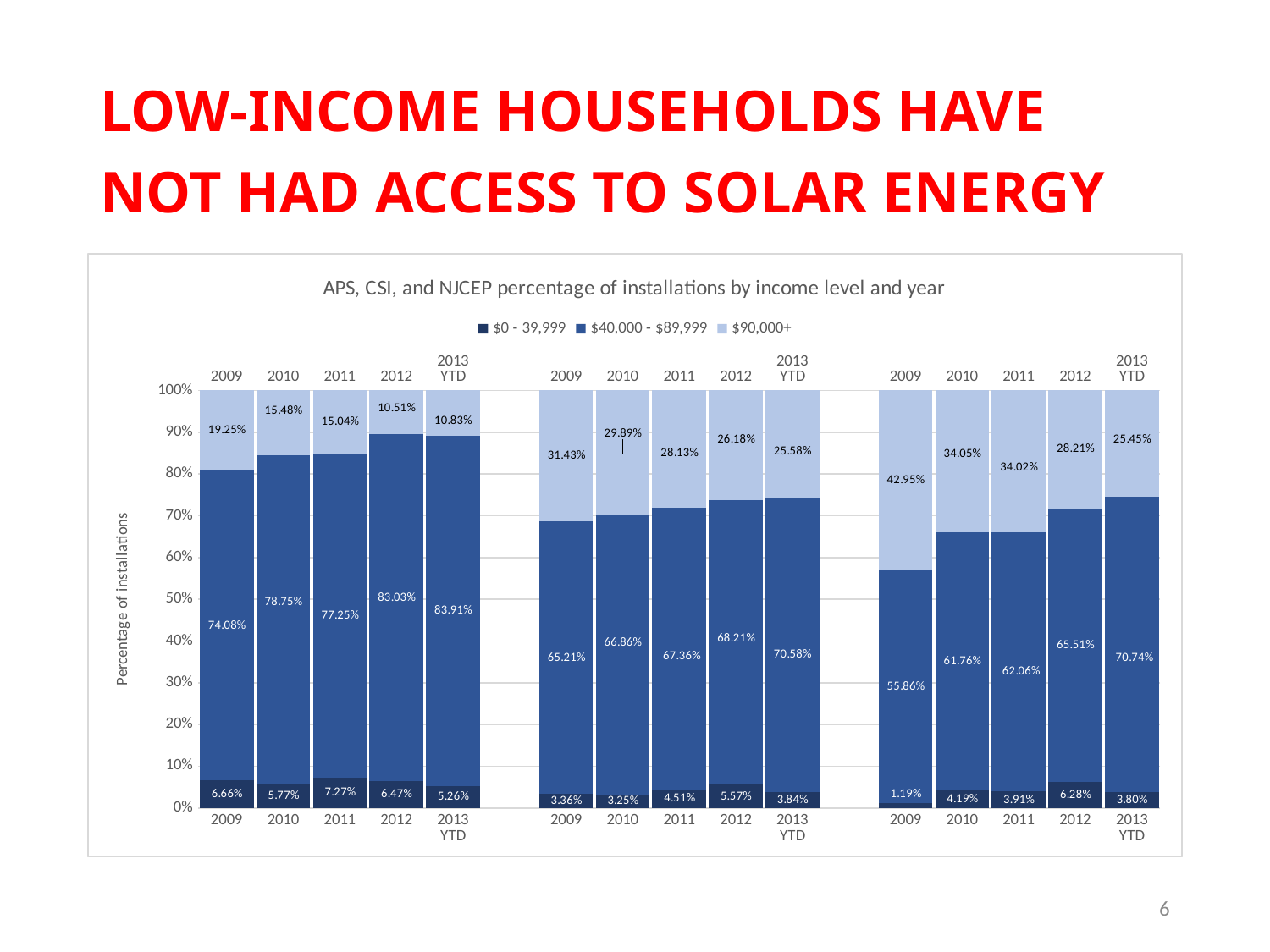
In the right group of bars, what is the value for the $40,000 - $89,999 series in 2013 YTD? 70.74% In the right group of bars, which year has the lowest value for the $0 - 39,999 series? 2009 In the left group of bars, what is the value for the $0 - 39,999 series in 2011? 7.27% In the middle group of bars, what is the value for the $90,000+ series in 2009? 31.43% How many years are shown in each group of bars? 5 What kind of chart is shown on the slide? Stacked bar chart How many series does the legend list? 3 In the middle group of bars, what is the difference between the $90,000+ values for 2009 and 2013 YTD? 5.85% What is the title of the chart? APS, CSI, and NJCEP percentage of installations by income level and year In the right group of bars, does the $90,000+ value rise or fall from 2009 to 2013 YTD? Fall In the left group of bars, which year has the highest value for the $40,000 - $89,999 series? 2013 YTD In the left group of bars, is the $0 - 39,999 value larger in 2010 or in 2012? 2012